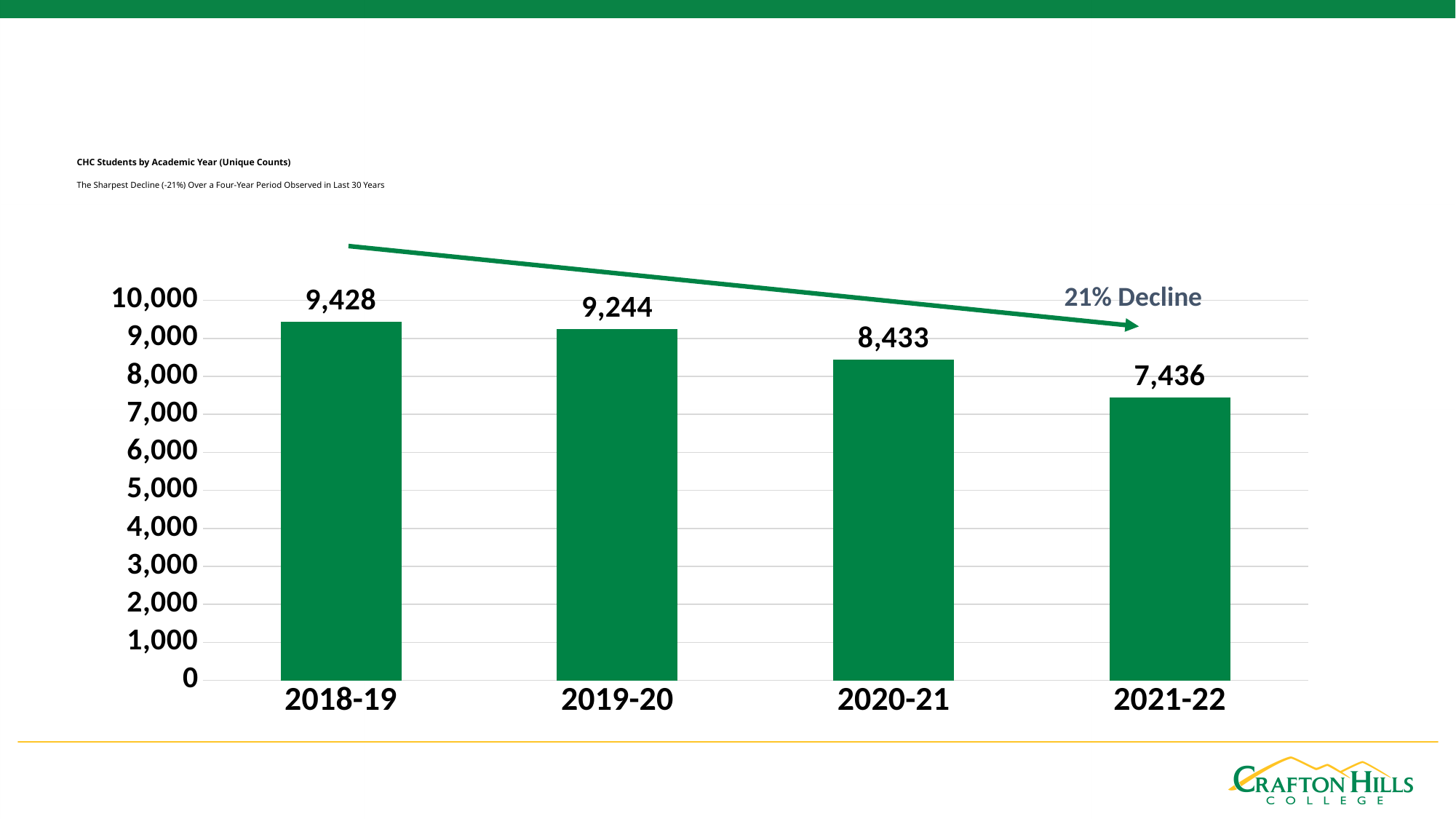
What is the number of CHC students for 2018-19? 9,428 Do the student counts rise or fall from 2018-19 to 2021-22? fall Is the value for 2021-22 greater or less than 8,000? less What is the difference in student counts between 2018-19 and 2021-22? 1,992 How many academic years are shown in the chart? 4 What is the difference in student counts between 2019-20 and 2020-21? 811 Which academic year has the lowest number of students? 2021-22 Which year has more students, 2019-20 or 2020-21? 2019-20 What is the number of CHC students for 2021-22? 7,436 Which academic year has the highest number of students? 2018-19 What is the number of CHC students for 2020-21? 8,433 What kind of chart is shown on the slide? bar chart